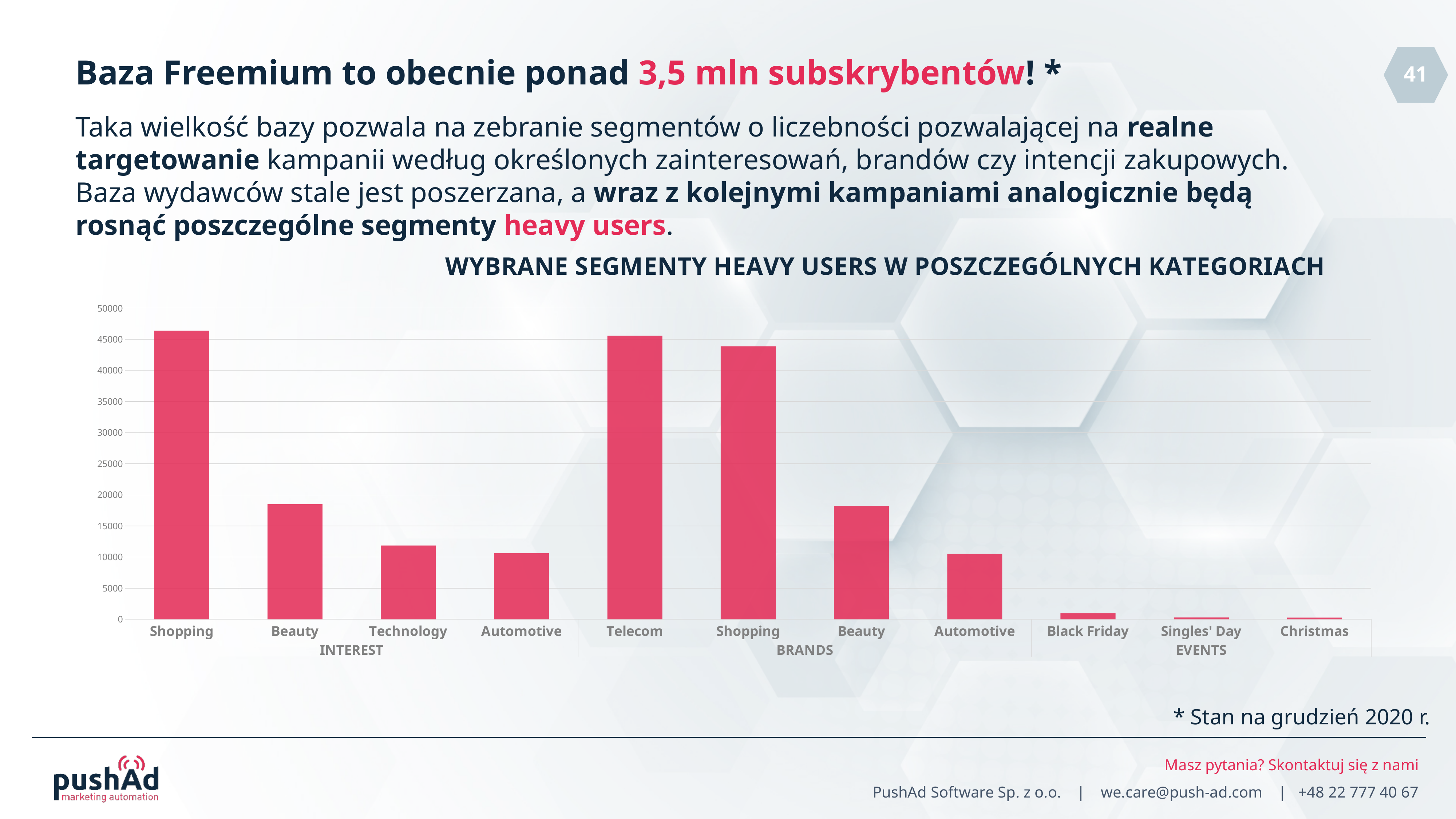
Is the value for Technology in the INTEREST group greater or less than 15000? less Is the value for Shopping in the INTEREST group greater or less than 40000? greater What kind of chart is shown on the slide? bar chart Is the value for Telecom in the BRANDS group greater or less than 40000? greater How many bars are plotted in the chart? 11 Which is larger: the value for Shopping in the INTEREST group or the value for Technology in the INTEREST group? Shopping How many categories are shown in the EVENTS group? 3 What is the title of the chart? WYBRANE SEGMENTY HEAVY USERS W POSZCZEGÓLNYCH KATEGORIACH Which is larger: the value for Telecom in the BRANDS group or the value for Beauty in the BRANDS group? Telecom What are the three category groups shown along the x axis? INTEREST, BRANDS, EVENTS